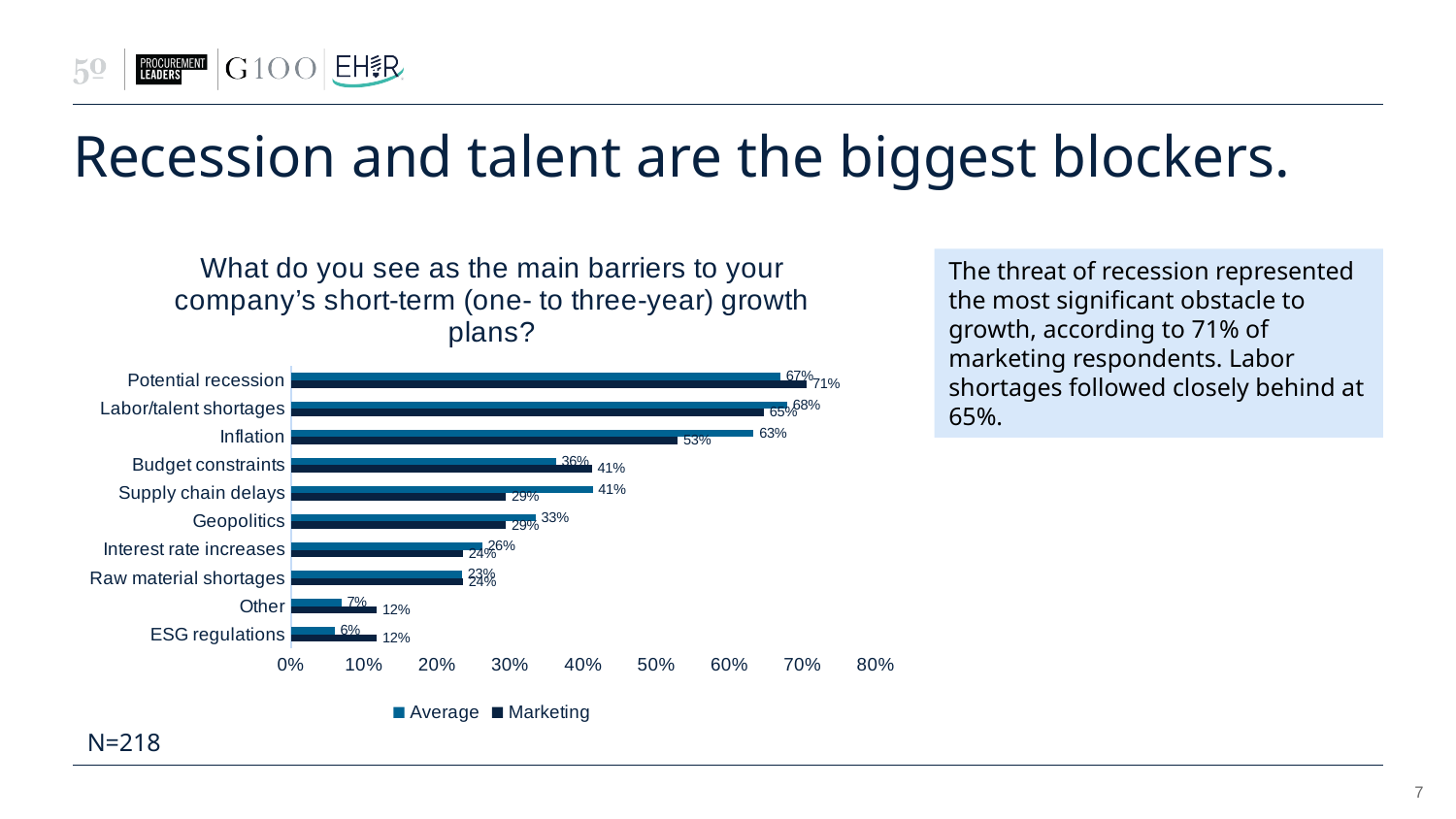
What is the difference between the Marketing and Average values for Potential recession? 4 percentage points What kind of chart is shown on the slide? Bar chart What is the Average value for Other? 7% What is the Average value for Inflation? 63% How many series does the chart's legend list? 2 For Inflation, which is larger: the Average value or the Marketing value? Average What are the two series named in the legend? Average and Marketing What is the Marketing value for Potential recession? 71% Which category has the highest Marketing value? Potential recession What is the Average value for Supply chain delays? 41% How many barrier categories are plotted on the chart? 10 Which category has the lowest Average value? ESG regulations